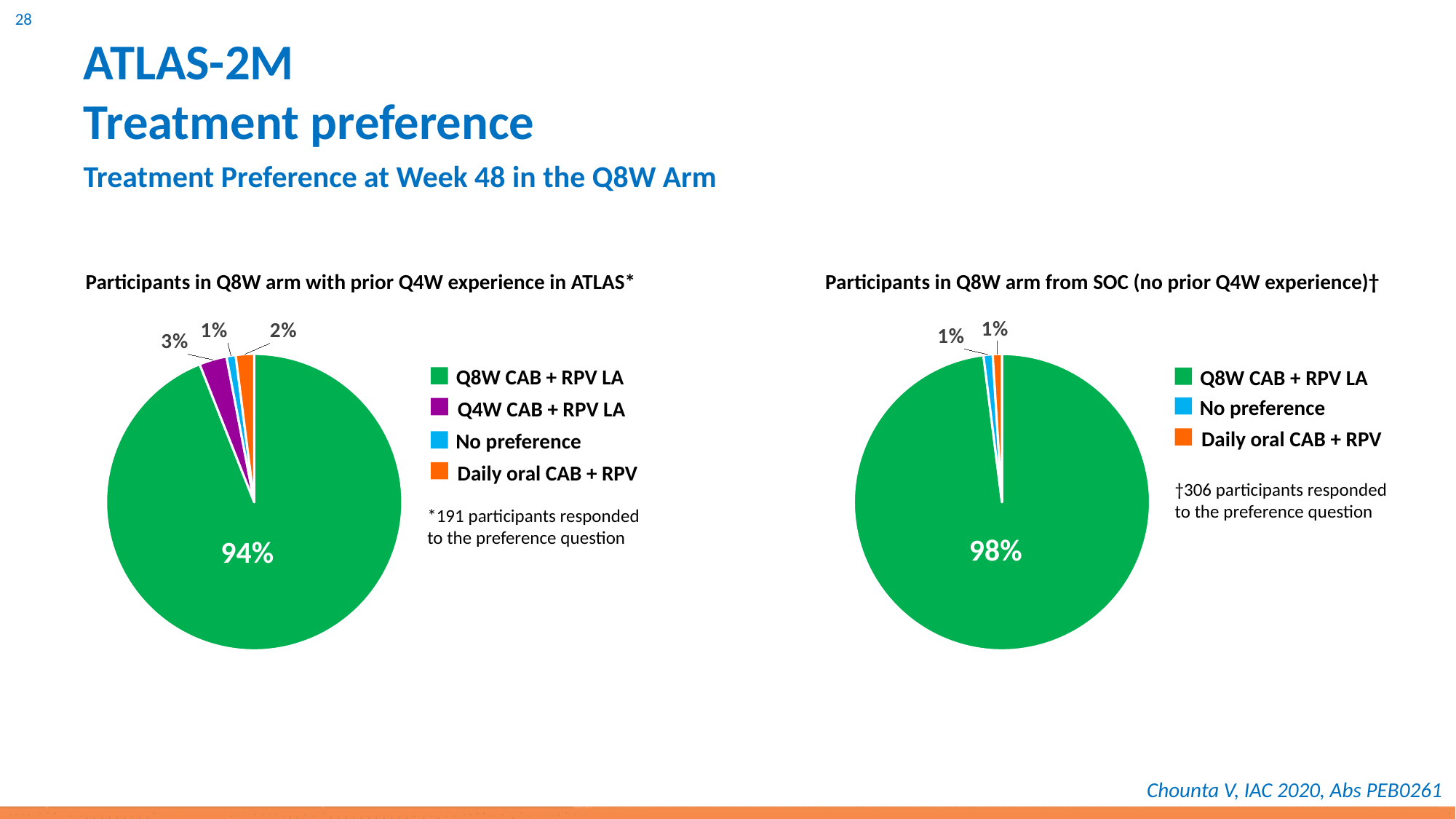
How many categories does the legend of the left pie chart (prior Q4W experience in ATLAS) list? 4 In the left pie chart (prior Q4W experience in ATLAS), what share of participants preferred Q4W CAB + RPV LA? 3% In the left pie chart (prior Q4W experience in ATLAS), which category has the largest slice? Q8W CAB + RPV LA In the left pie chart (prior Q4W experience in ATLAS), what share of participants preferred daily oral CAB + RPV? 2% What type of chart is used on this slide to show treatment preference? Pie chart In the right pie chart (from SOC, no prior Q4W experience), what share of participants preferred Q8W CAB + RPV LA? 98% What is the difference between the Q8W CAB + RPV LA share in the right pie chart and the Q8W CAB + RPV LA share in the left pie chart? 4% In the left pie chart (prior Q4W experience in ATLAS), which category has the smallest slice? No preference How many categories does the legend of the right pie chart (from SOC, no prior Q4W experience) list? 3